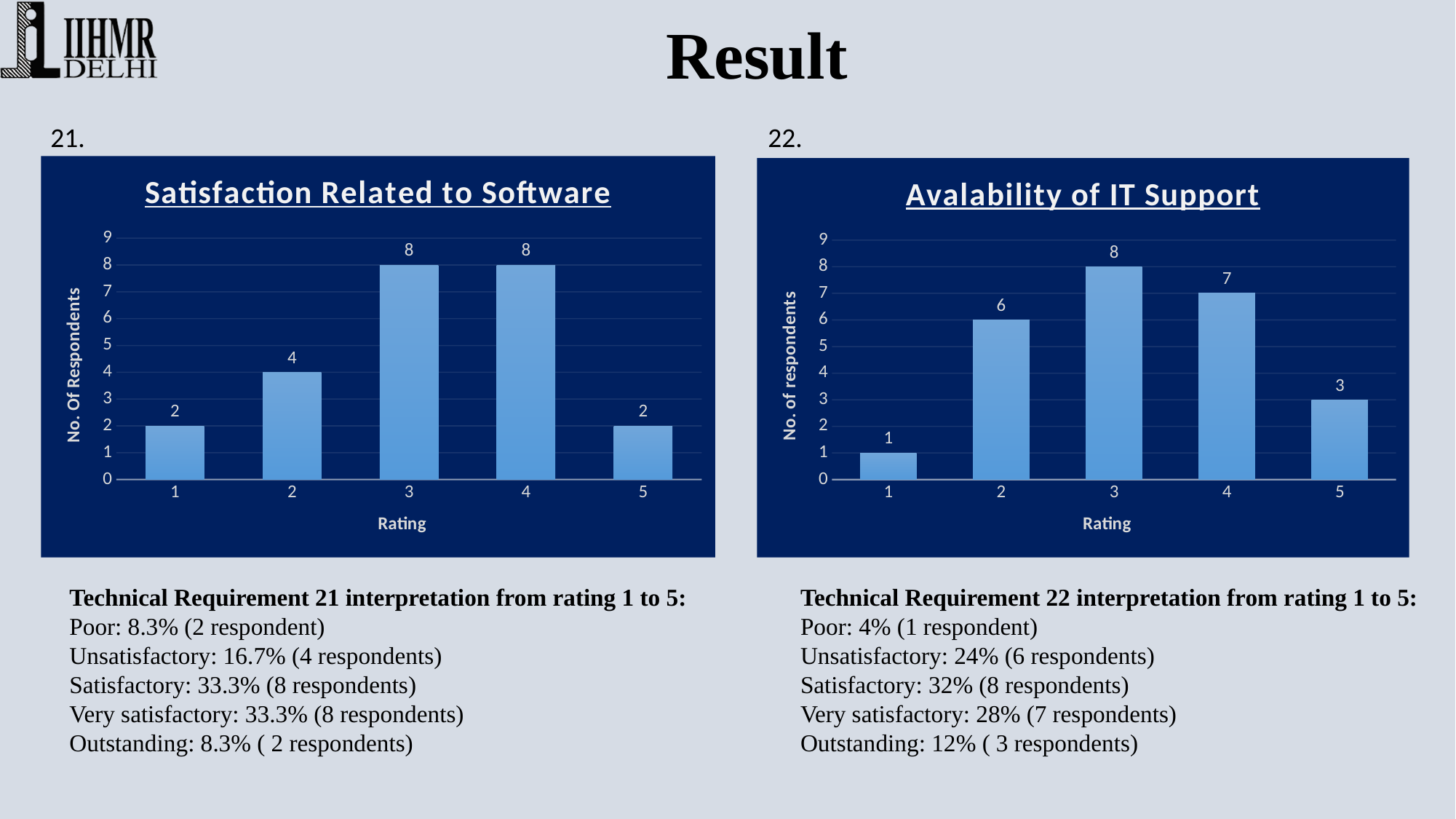
How many rating categories are shown on the x axis of the 'Satisfaction Related to Software' chart? 5 In the 'Avalability of IT Support' chart, which has more respondents: rating 2 or rating 5? Rating 2 In the 'Satisfaction Related to Software' chart, how many respondents gave a rating of 2? 4 What is the label of the x axis on the 'Avalability of IT Support' chart? Rating In the 'Avalability of IT Support' chart, which rating has the lowest number of respondents? 1 What type of chart is the 'Avalability of IT Support' chart? Bar chart In the 'Satisfaction Related to Software' chart, what is the difference between the number of respondents for rating 3 and rating 2? 4 In the 'Avalability of IT Support' chart, how many respondents gave a rating of 4? 7 What is the label of the y axis on the 'Satisfaction Related to Software' chart? No. Of Respondents In the 'Satisfaction Related to Software' chart, how many respondents gave a rating of 5? 2 In the 'Avalability of IT Support' chart, what is the difference between the number of respondents for rating 3 and rating 1? 7 In the 'Avalability of IT Support' chart, which rating has the highest number of respondents? 3